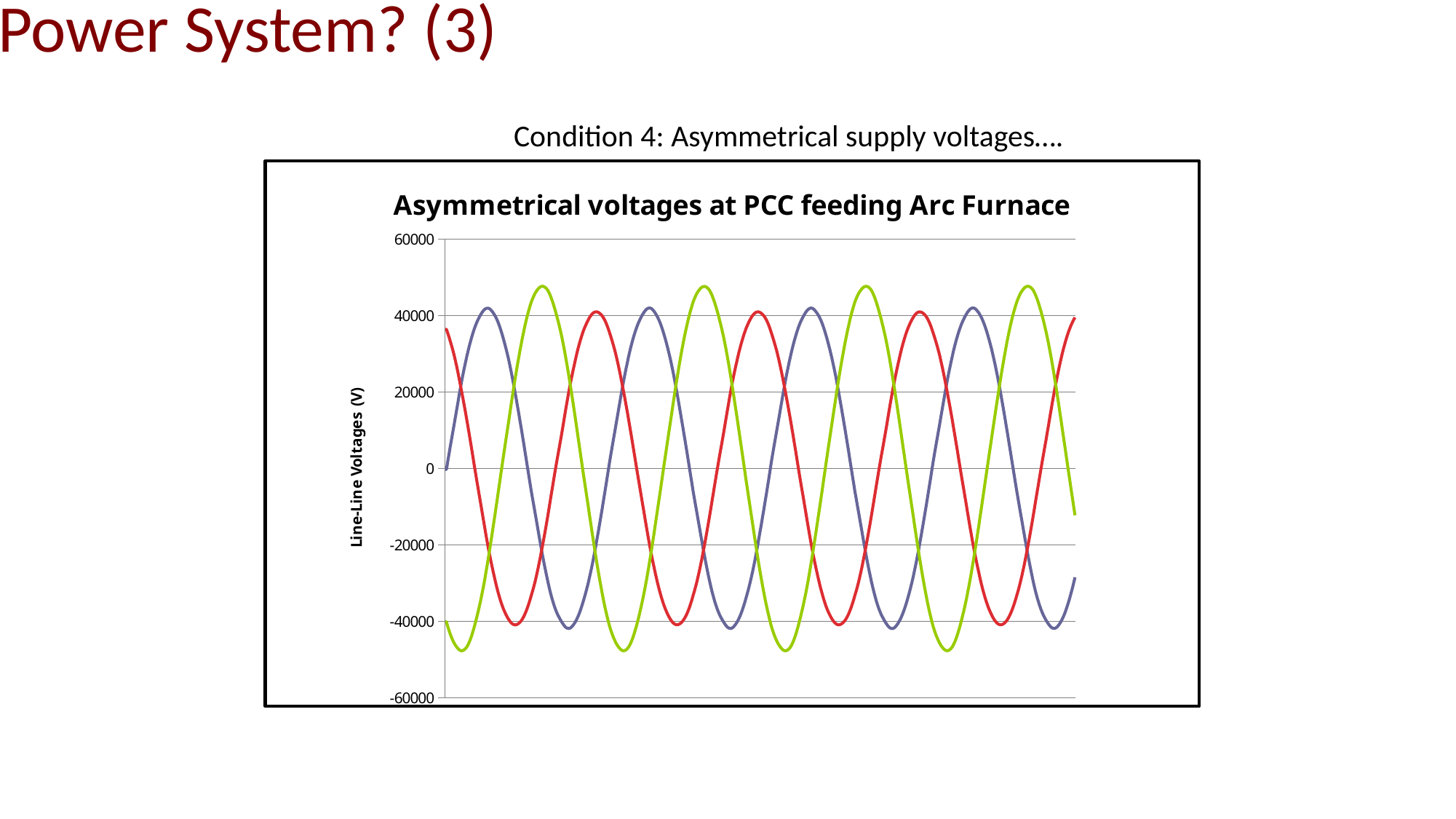
What kind of chart is shown on the slide? line chart Is the peak of the green line larger than the peak of the red line? yes Is the peak value of the green line greater or less than 60000? less Which coloured line reaches the highest peak value? green What is the lowest value shown on the vertical axis? -60000 Is the peak value of the green line greater or less than 40000? greater What is the label on the vertical axis of the chart? Line-Line Voltages (V) Which coloured line reaches the lowest trough value? green What is the title of the chart? Asymmetrical voltages at PCC feeding Arc Furnace How many lines (waveforms) are plotted on the chart? 3 What is the highest value shown on the vertical axis? 60000 Is the minimum value of the green line greater or less than -40000? less